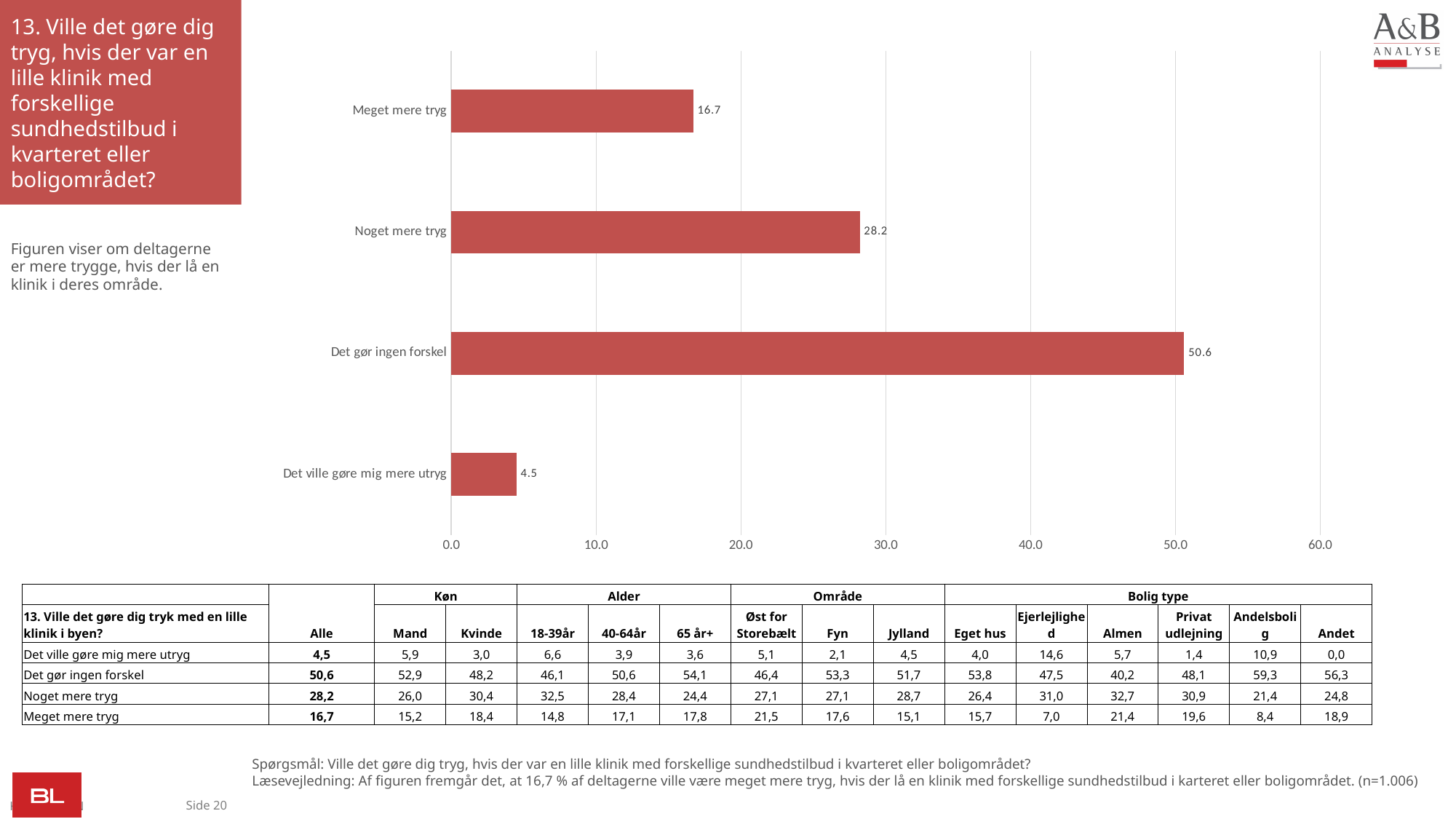
Is the value for "Det gør ingen forskel" greater or less than 40.0? greater What is the maximum value shown on the horizontal axis of the bar chart? 60.0 Which is larger: the value for "Meget mere tryg" or the value for "Det ville gøre mig mere utryg"? Meget mere tryg What kind of chart is shown on the slide? Bar chart What is the difference between the values for "Noget mere tryg" and "Meget mere tryg"? 11.5 What is the value for "Meget mere tryg" in the bar chart? 16.7 What is the value for "Det gør ingen forskel" in the bar chart? 50.6 How many categories are shown in the bar chart? 4 Which category has the highest value in the bar chart? Det gør ingen forskel What is the value for "Det ville gøre mig mere utryg" in the bar chart? 4.5 Which category has the lowest value in the bar chart? Det ville gøre mig mere utryg What is the value for "Noget mere tryg" in the bar chart? 28.2